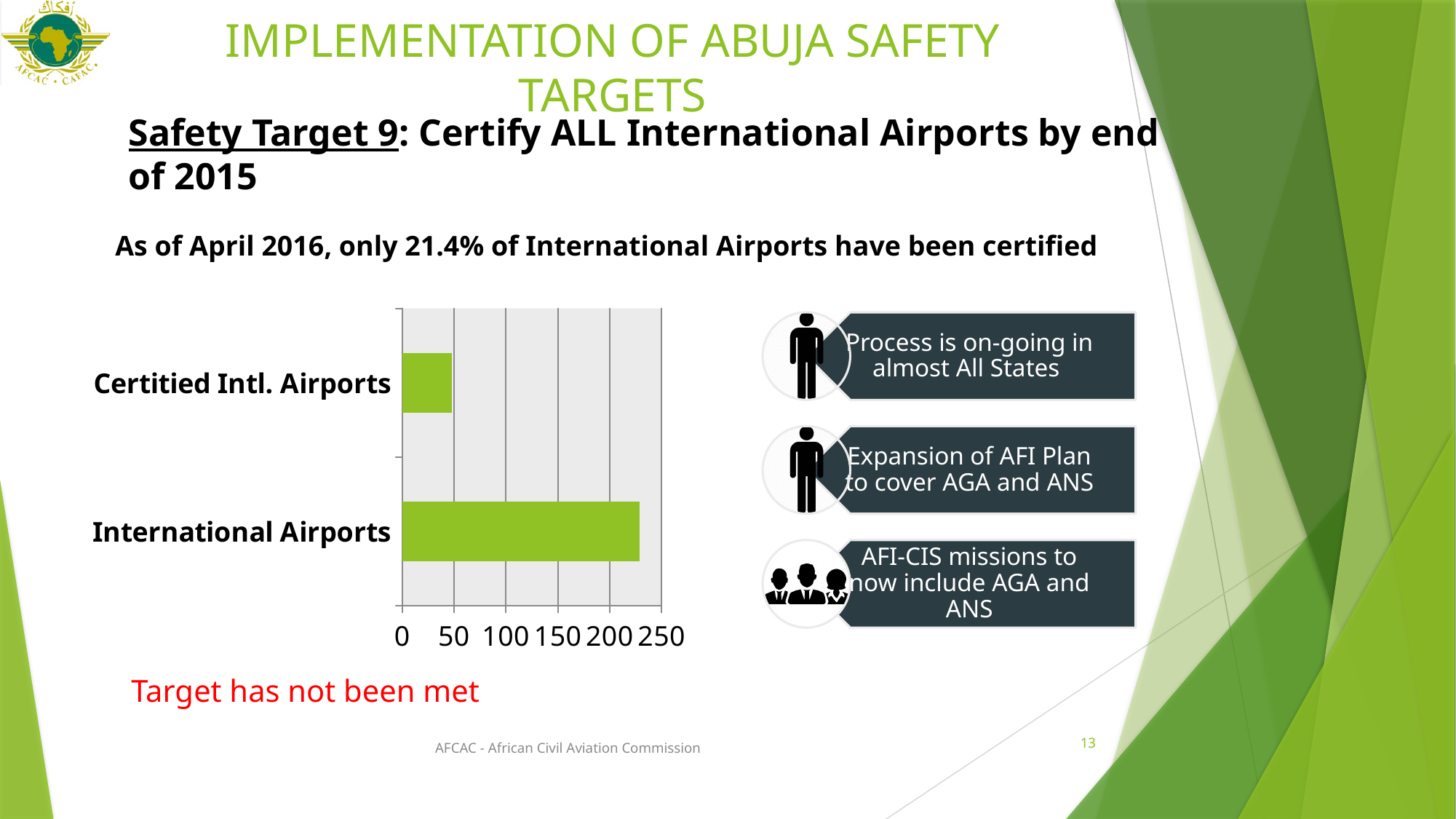
Which category has the shortest bar in the chart? Certitied Intl. Airports Is the value for International Airports greater or less than 200? greater Is the value for Certitied Intl. Airports greater or less than 100? less Which is larger, the value for International Airports or the value for Certitied Intl. Airports? International Airports Is the value for Certitied Intl. Airports greater or less than 150? less How many categories does the bar chart show? 2 Which category has the longest bar in the chart? International Airports What is the highest tick value shown on the chart's value axis? 250 What colour are the bars in the chart? green What kind of chart is shown on the slide? bar chart